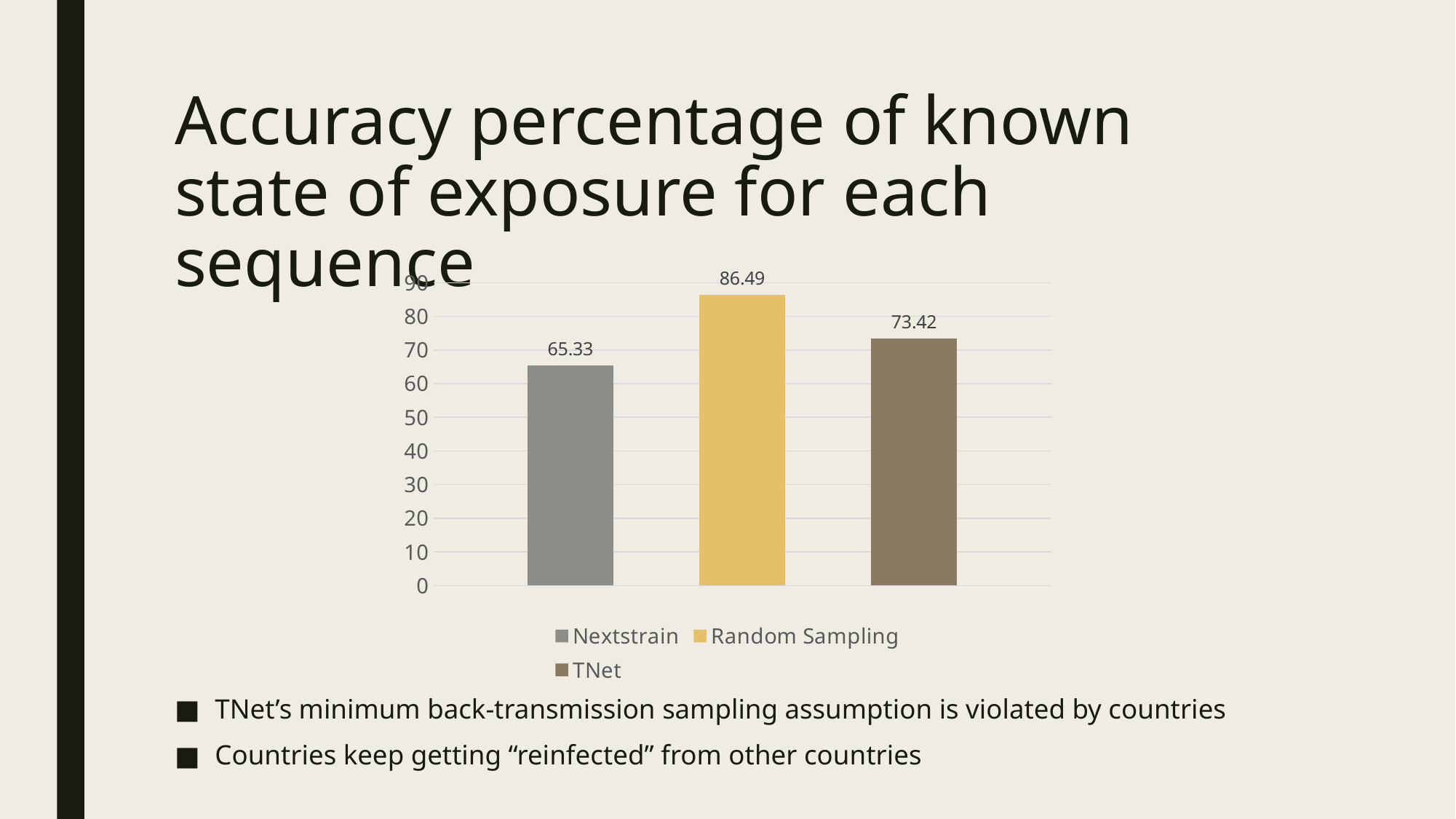
What is the accuracy percentage for TNet? 73.42 Which method has the highest accuracy percentage? Random Sampling Which has a higher accuracy percentage, TNet or Nextstrain? TNet What kind of chart is shown on the slide? bar chart Is the value for TNet greater or less than 70? greater What is the difference between the accuracy of TNet and Nextstrain? 8.09 What is the accuracy percentage for Nextstrain? 65.33 How many series does the legend list? 3 What is the difference between the accuracy of Random Sampling and Nextstrain? 21.16 Which method has the lowest accuracy percentage? Nextstrain What is the accuracy percentage for Random Sampling? 86.49 What colour is the bar for Random Sampling? yellow